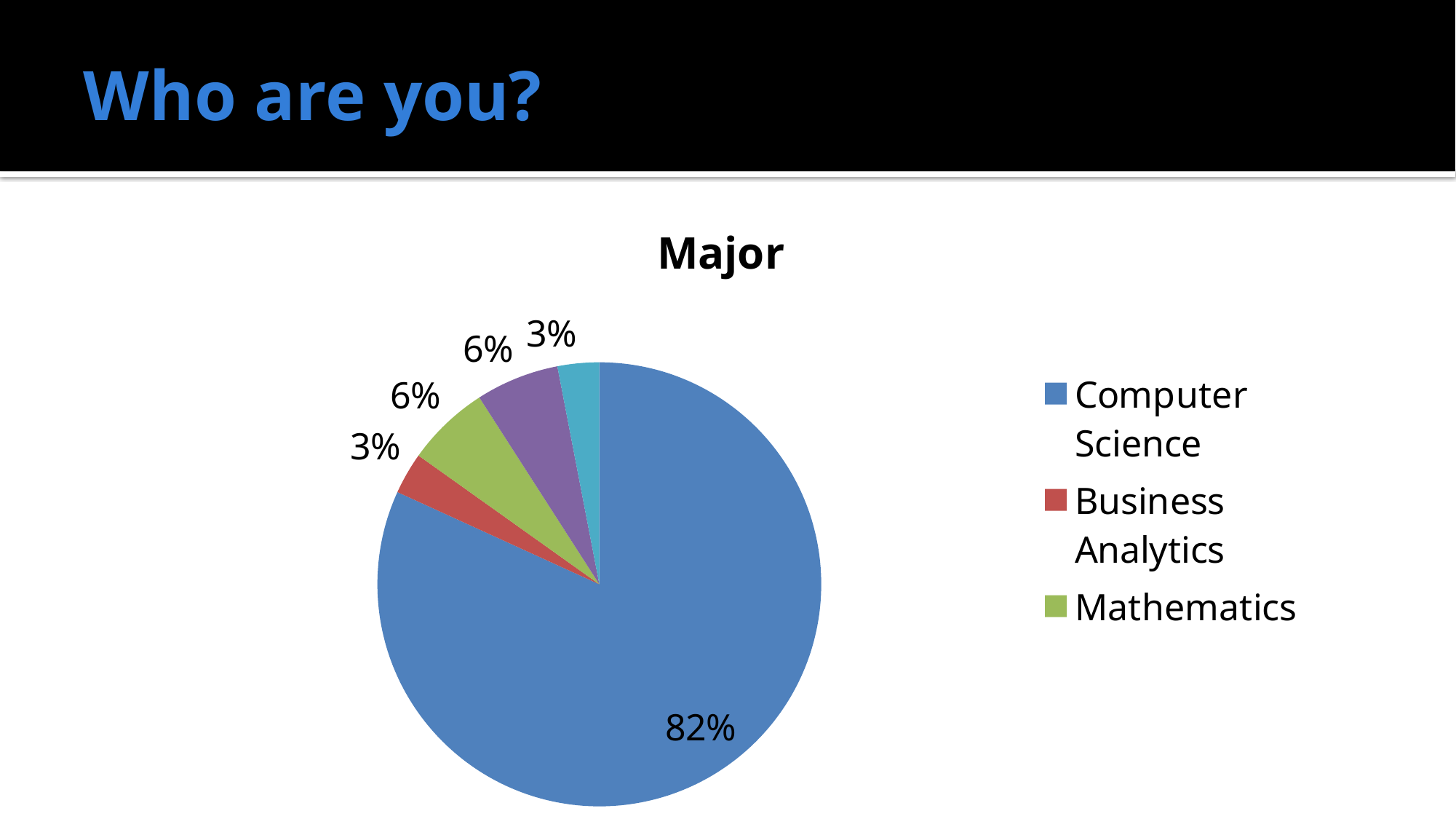
What is the title of the chart? Major What colour is the Computer Science slice? blue Which is larger, the share for Mathematics or the share for Business Analytics? Mathematics What type of chart is shown on the slide? pie chart What is the difference in percentage points between Computer Science and Mathematics? 76 How many entries does the legend list? 3 What is the difference in percentage points between Mathematics and Business Analytics? 3 What percentage of the pie is Computer Science? 82% How many slices does the pie chart have? 5 What percentage of the pie is Business Analytics? 3% What percentage of the pie is Mathematics? 6% Which major has the largest share of the pie? Computer Science